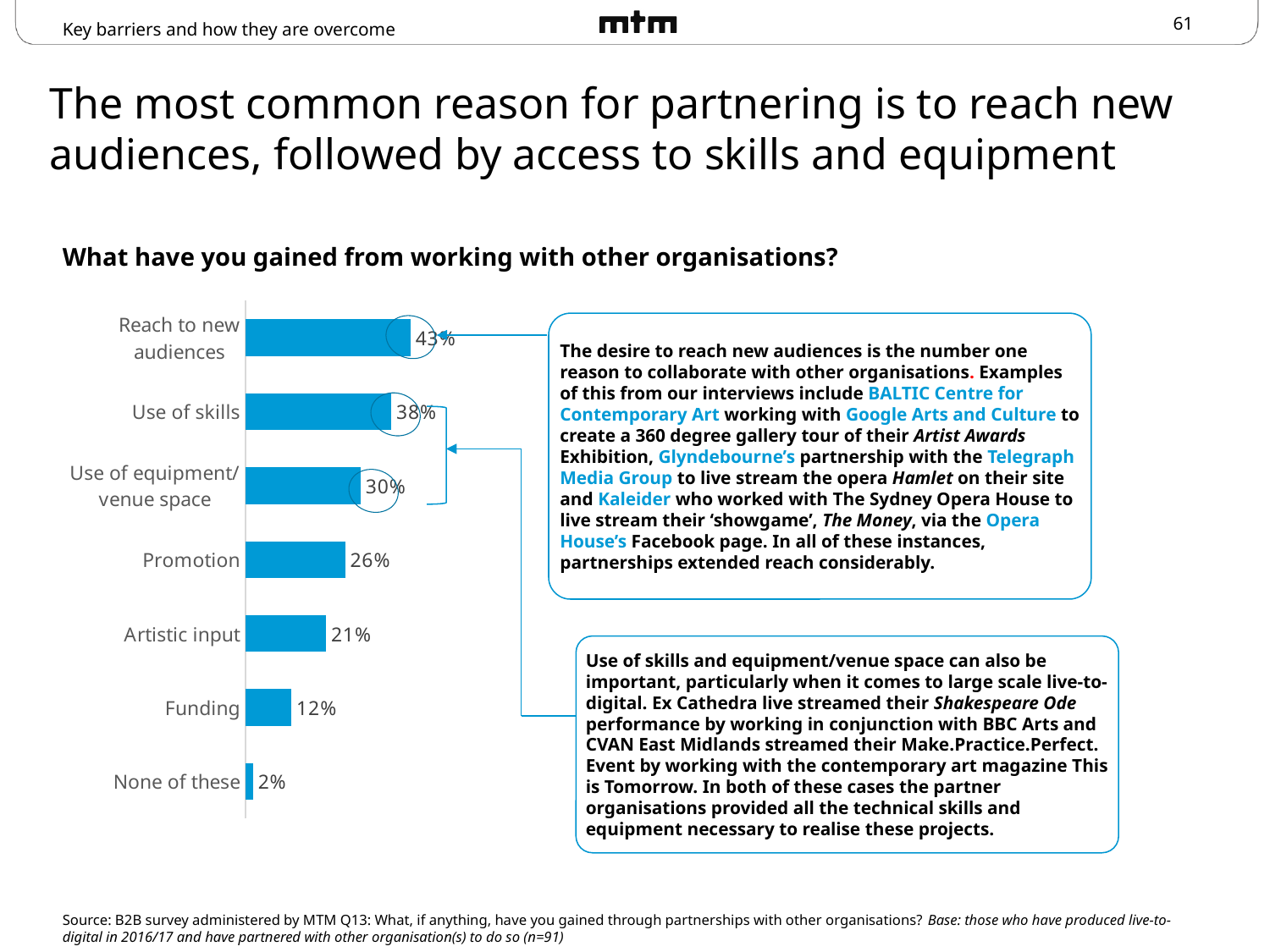
Which has a higher value, 'Promotion' or 'Funding'? Promotion What is the value shown for 'Use of equipment/ venue space'? 30% Which category has the lowest value in the chart? None of these What is the difference between the values for 'Promotion' and 'Artistic input'? 5% What percentage is shown for 'Funding'? 12% How many categories are shown in the chart? 7 What type of chart is shown on the slide? Bar chart What is the value shown for 'Use of skills'? 38% What is the difference between the values for 'Reach to new audiences' and 'Use of skills'? 5% Which category has the highest value in the chart? Reach to new audiences What question is the chart answering, as shown in its heading? What have you gained from working with other organisations? What percentage of respondents gained 'Reach to new audiences' from working with other organisations? 43%